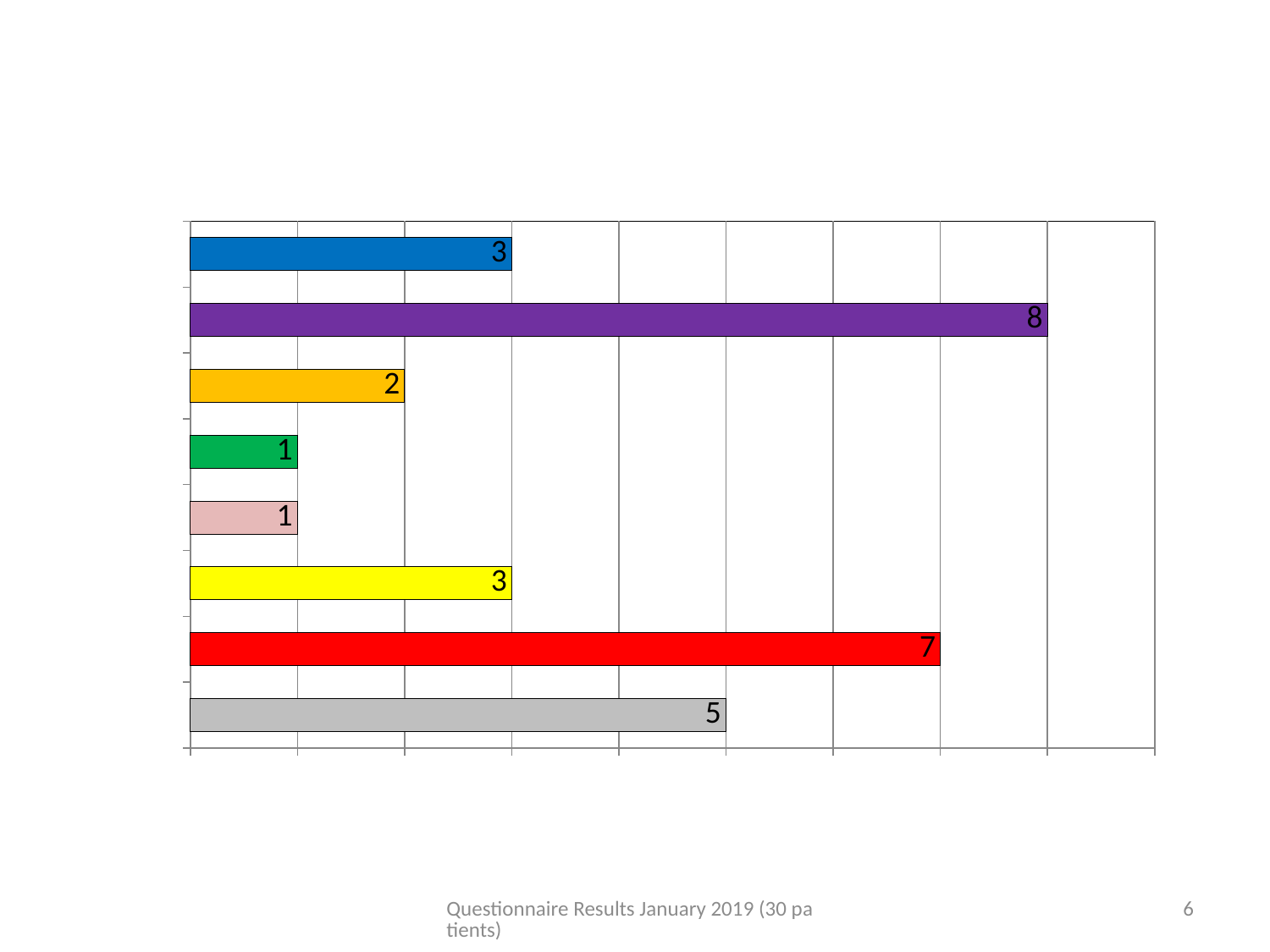
What is the value shown on the orange bar? 2 What is the value shown on the red bar? 7 What is the difference between the grey bar's value and the yellow bar's value? 2 What is the value shown on the purple bar? 8 What is the value shown on the blue bar at the top of the chart? 3 What is the value shown on the grey bar at the bottom of the chart? 5 What is the difference between the purple bar's value and the red bar's value? 1 Which colour bar has the highest value? purple How many bars does the chart contain? 8 What is the lowest value shown on any bar in the chart? 1 What kind of chart is shown on the slide? bar chart Which bar has the larger value, the red bar or the grey bar? red bar